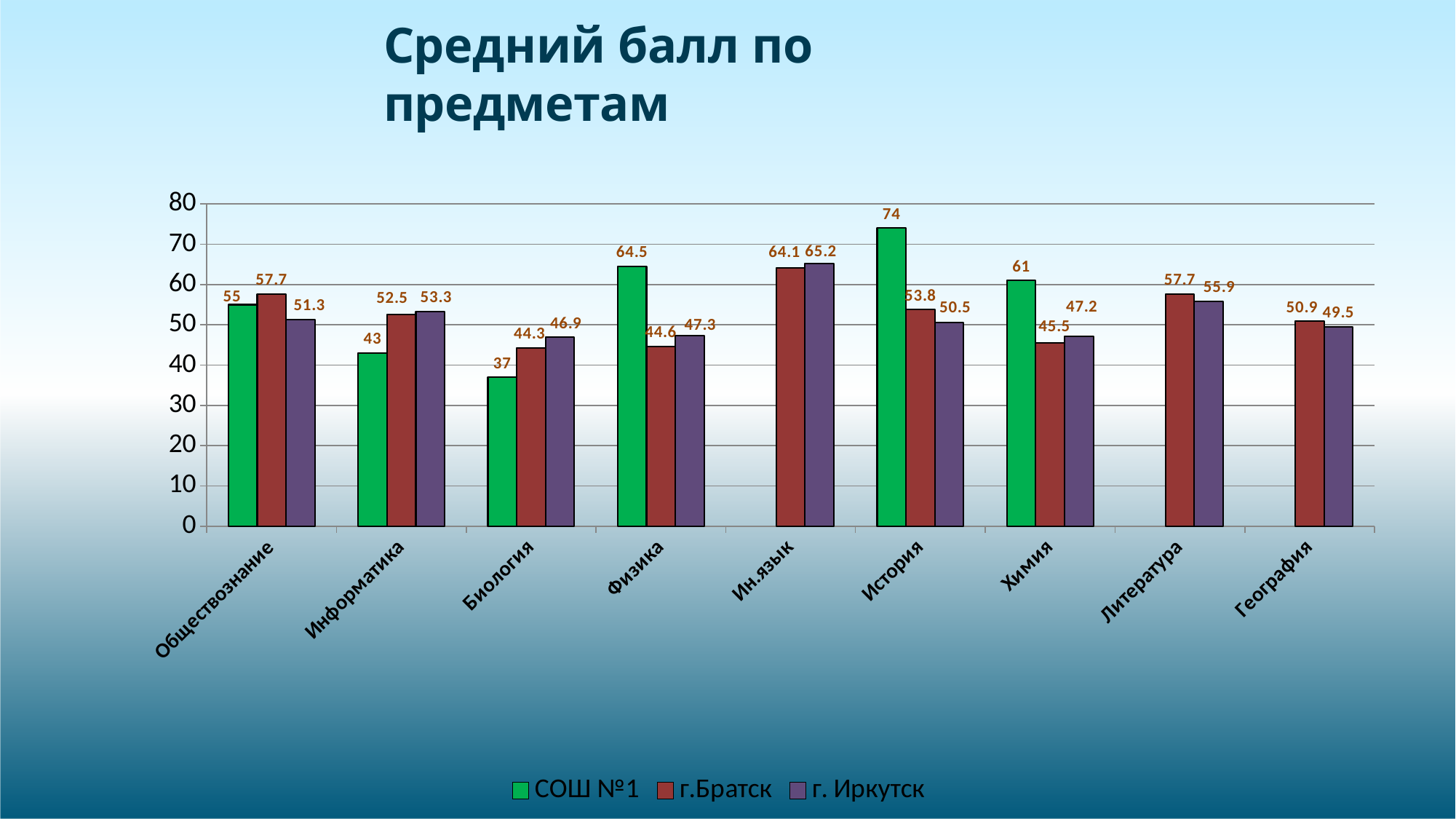
How many subjects are shown on the x axis? 9 In Информатика, which is larger: the value for г.Братск or the value for г. Иркутск? г. Иркутск What kind of chart is shown on the slide? bar chart Which subject has the highest value for г. Иркутск? Ин.язык What is the difference between the СОШ №1 and г.Братск values in Физика? 19.9 What is the value for г.Братск in География? 50.9 How many series does the legend list? 3 What is the value for СОШ №1 in История? 74 What is the title of the chart? Средний балл по предметам What is the value for г. Иркутск in Биология? 46.9 Which subject has the highest value for СОШ №1? История Which subject has the lowest value for СОШ №1? Биология